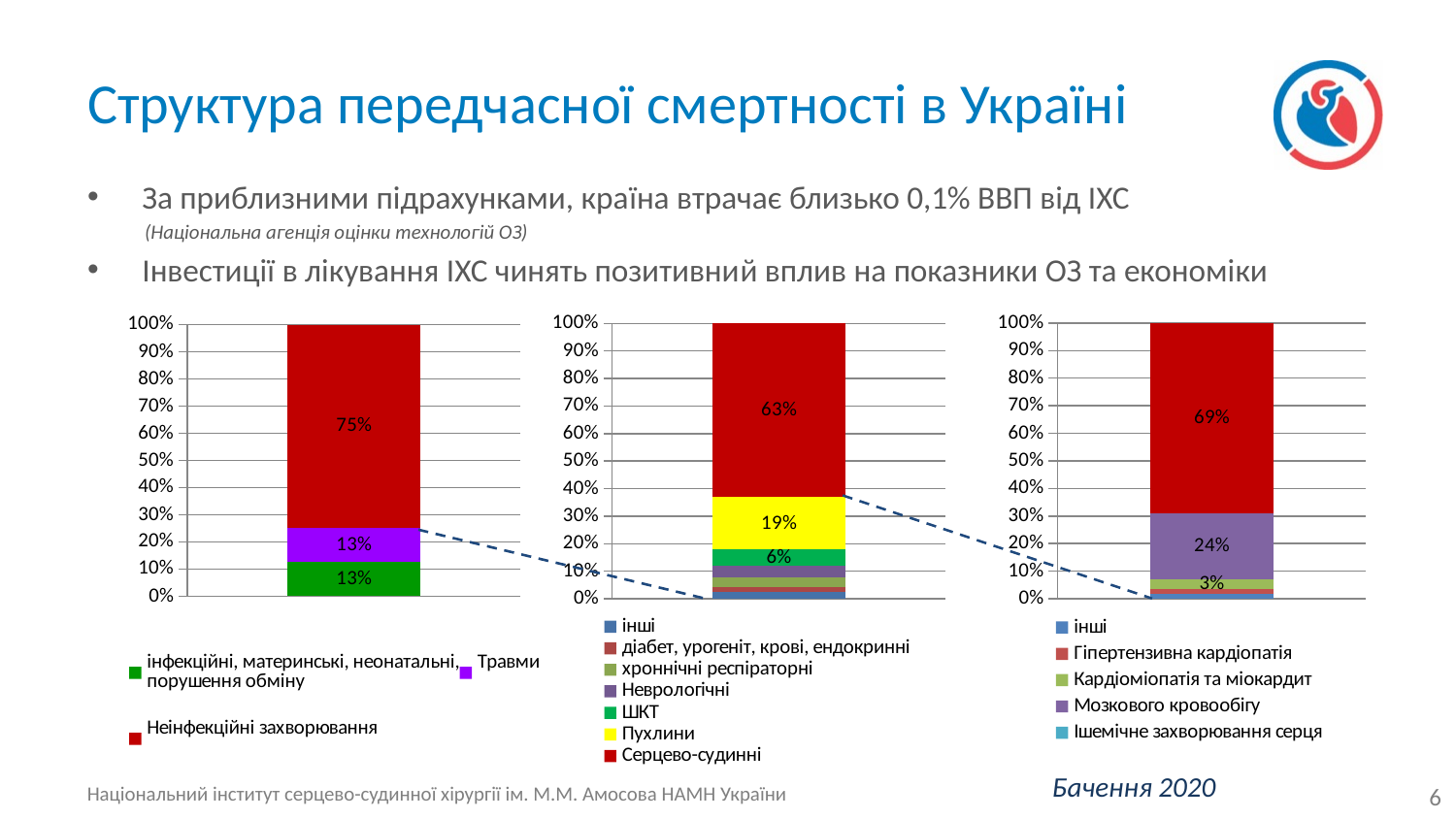
In the middle chart, what is the difference between the Серцево-судинні and Пухлини percentages? 44% What type of chart is used on this slide? Stacked bar chart In the middle chart, how many entries does the legend list? 7 In the middle chart, which is larger, Пухлини or ШКТ? Пухлини In the middle chart, what percentage is shown for ШКТ? 6% In the left chart, what percentage is shown for Неінфекційні захворювання? 75% In the left chart, which category has the largest share of the bar? Неінфекційні захворювання In the left chart, what percentage is shown for Травми? 13% In the middle chart, what percentage is shown for Серцево-судинні? 63% In the right chart, what percentage is shown on the largest segment of the bar? 69% In the right chart, what percentage is shown on the purple segment? 24% In the middle chart, what percentage is shown for Пухлини? 19%